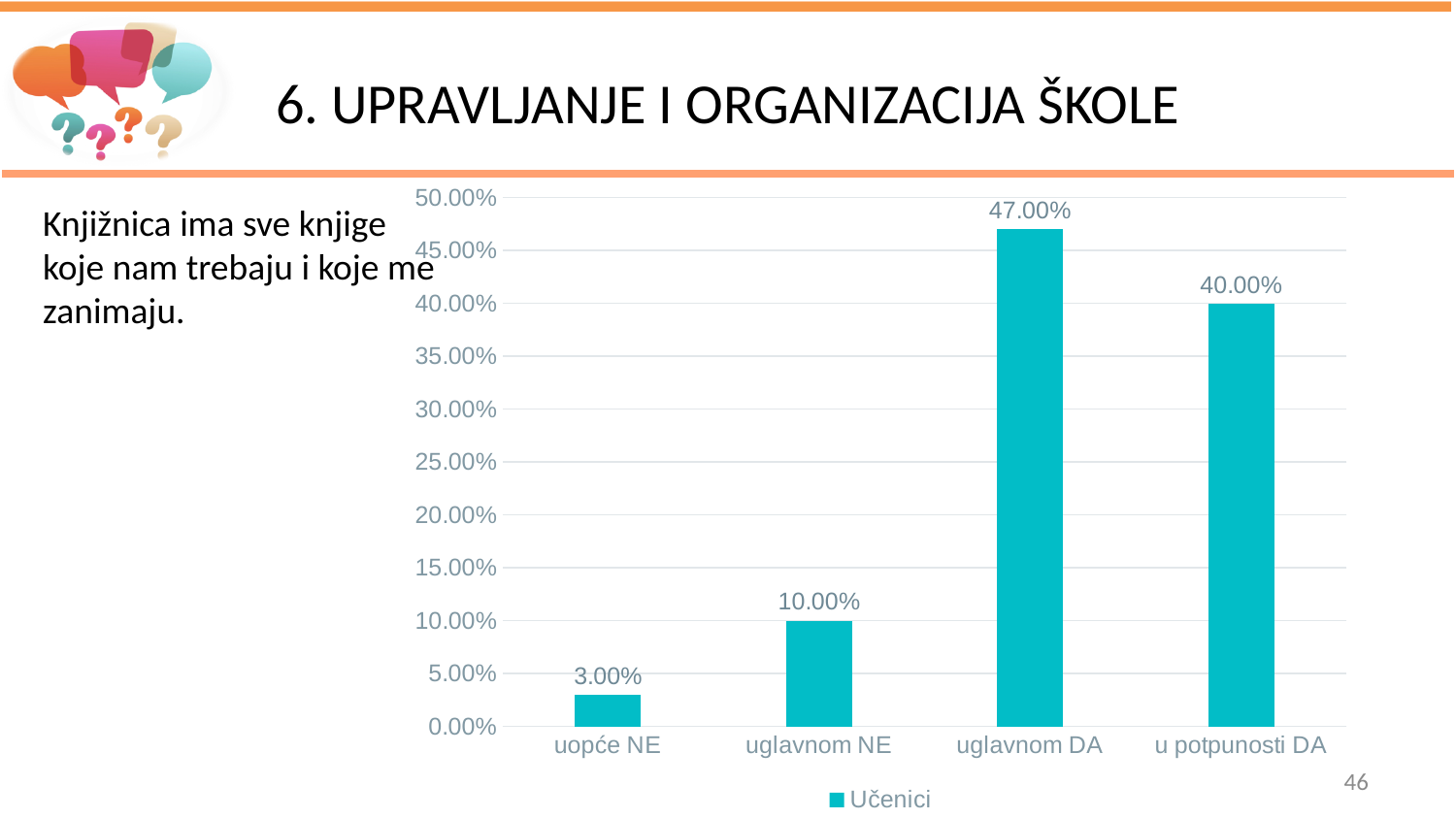
Is the value for 'u potpunosti DA' greater or less than 35.00%? greater What is the value for 'uopće NE'? 3.00% Which category has the lowest value? uopće NE How many categories are shown on the x axis? 4 What is the value for 'u potpunosti DA'? 40.00% What is the difference between the values for 'uglavnom DA' and 'u potpunosti DA'? 7.00% Which category has the highest value? uglavnom DA How many series does the legend list? 1 What is the value for 'uglavnom DA'? 47.00% What is the name of the series shown in the legend? Učenici Which is larger, the value for 'uglavnom NE' or the value for 'uopće NE'? uglavnom NE What kind of chart is shown on the slide? bar chart